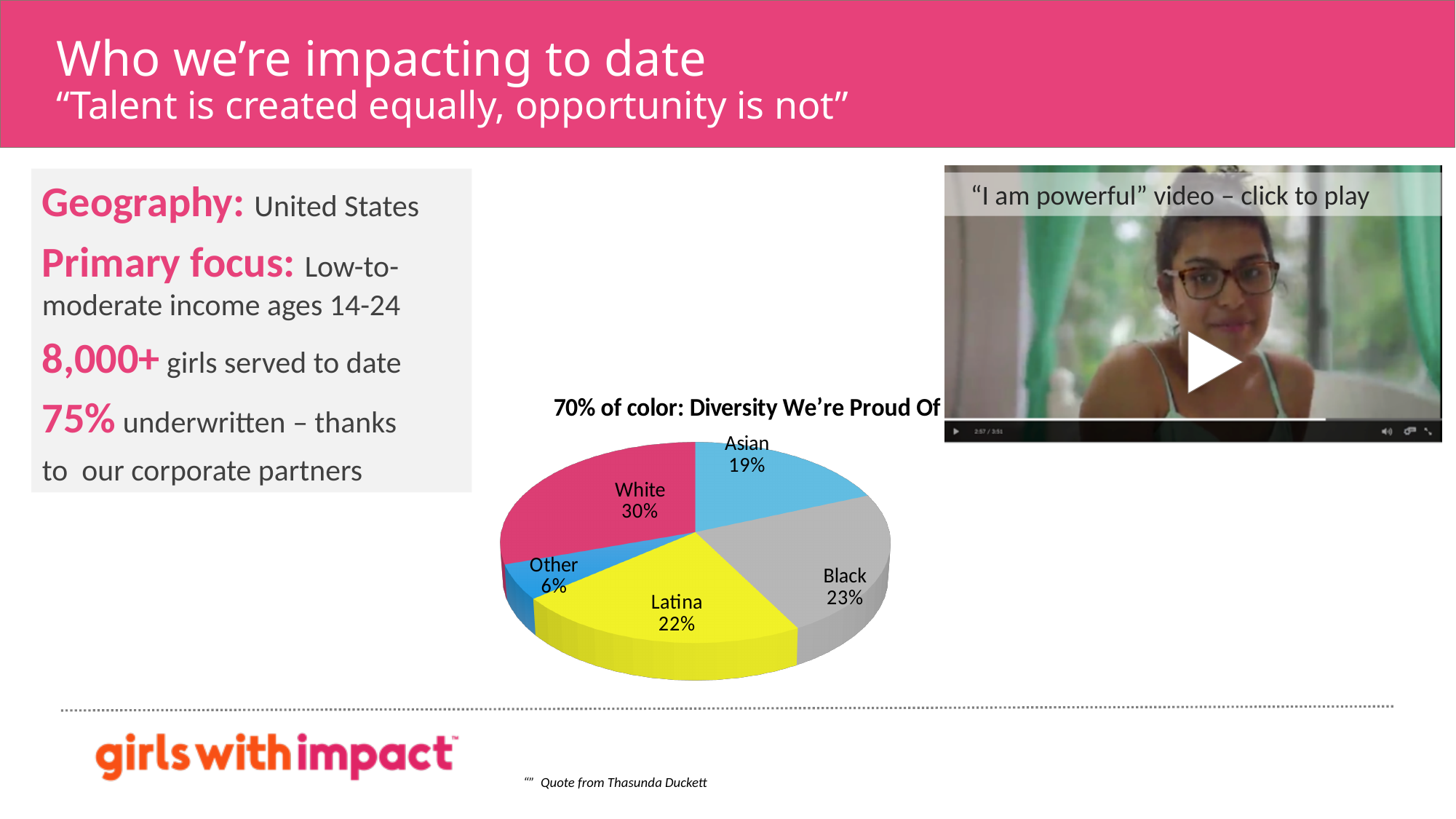
Which category has the smallest share of the pie chart? Other What percentage of the pie chart is labelled Latina? 22% What percentage of the pie chart is labelled Other? 6% What percentage of the pie chart is labelled Black? 23% Which category has the largest share of the pie chart? White How many categories are shown in the pie chart? 5 Which slice is larger, Black or Latina? Black What percentage of the pie chart is labelled White? 30% What type of chart is shown on the slide? Pie chart What is the title of the pie chart? 70% of color: Diversity We're Proud Of What percentage of the pie chart is labelled Asian? 19% What is the difference in percentage points between the White and Asian slices? 11